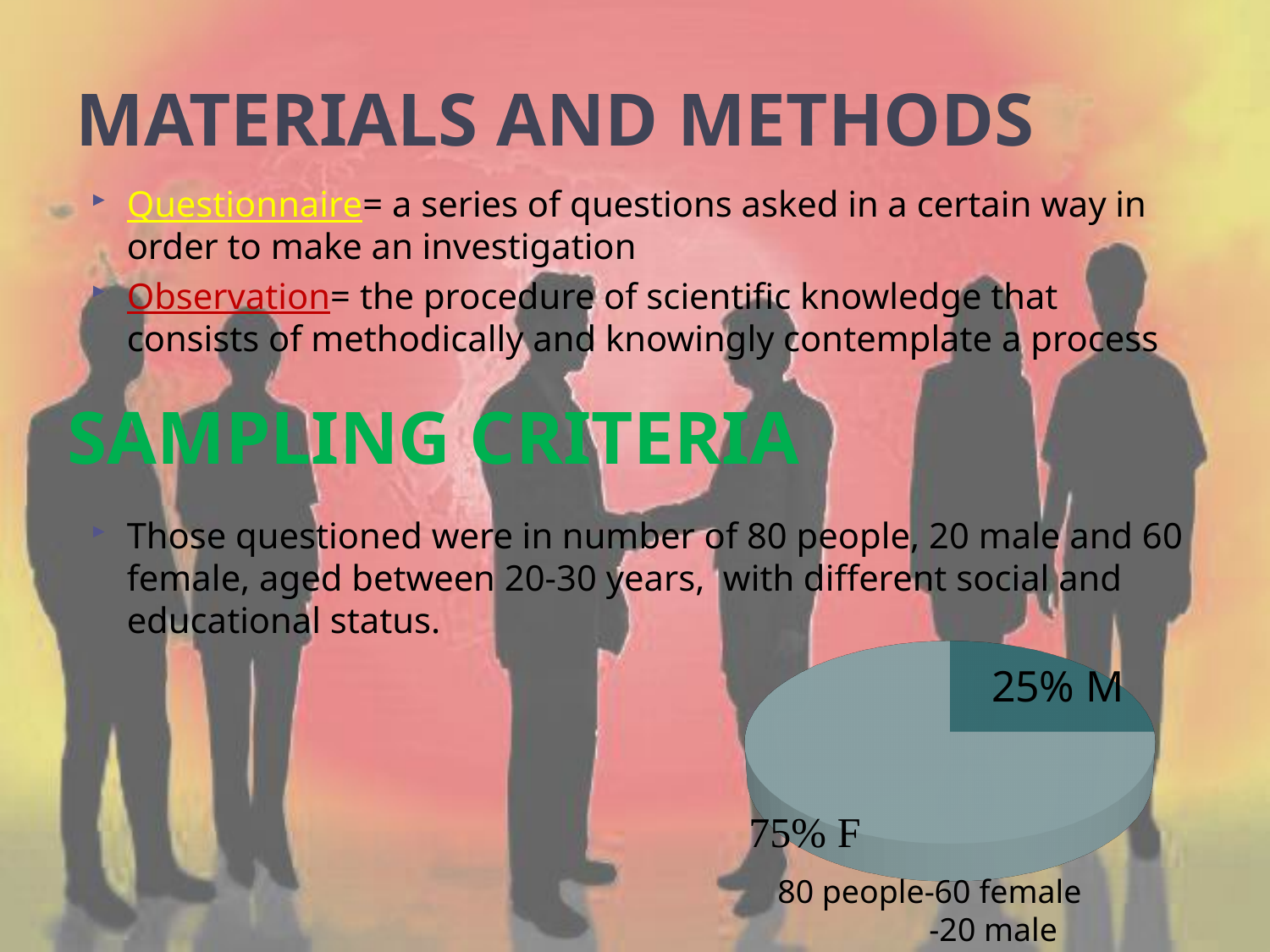
Which slice of the pie chart is the largest? 75% F What share of the pie chart is labelled F? 75% According to the text below the pie chart, how many people in total were questioned? 80 people Which is larger in the pie chart, the M slice or the F slice? F According to the text below the pie chart, how many of the people questioned were female? 60 What share of the pie chart is labelled M? 25% What kind of chart is shown on the slide? pie chart How many slices does the pie chart have? 2 What is the difference in percentage points between the F slice and the M slice in the pie chart? 50% Which slice of the pie chart is the smallest? 25% M Is the share of the M slice in the pie chart greater or less than 50%? less